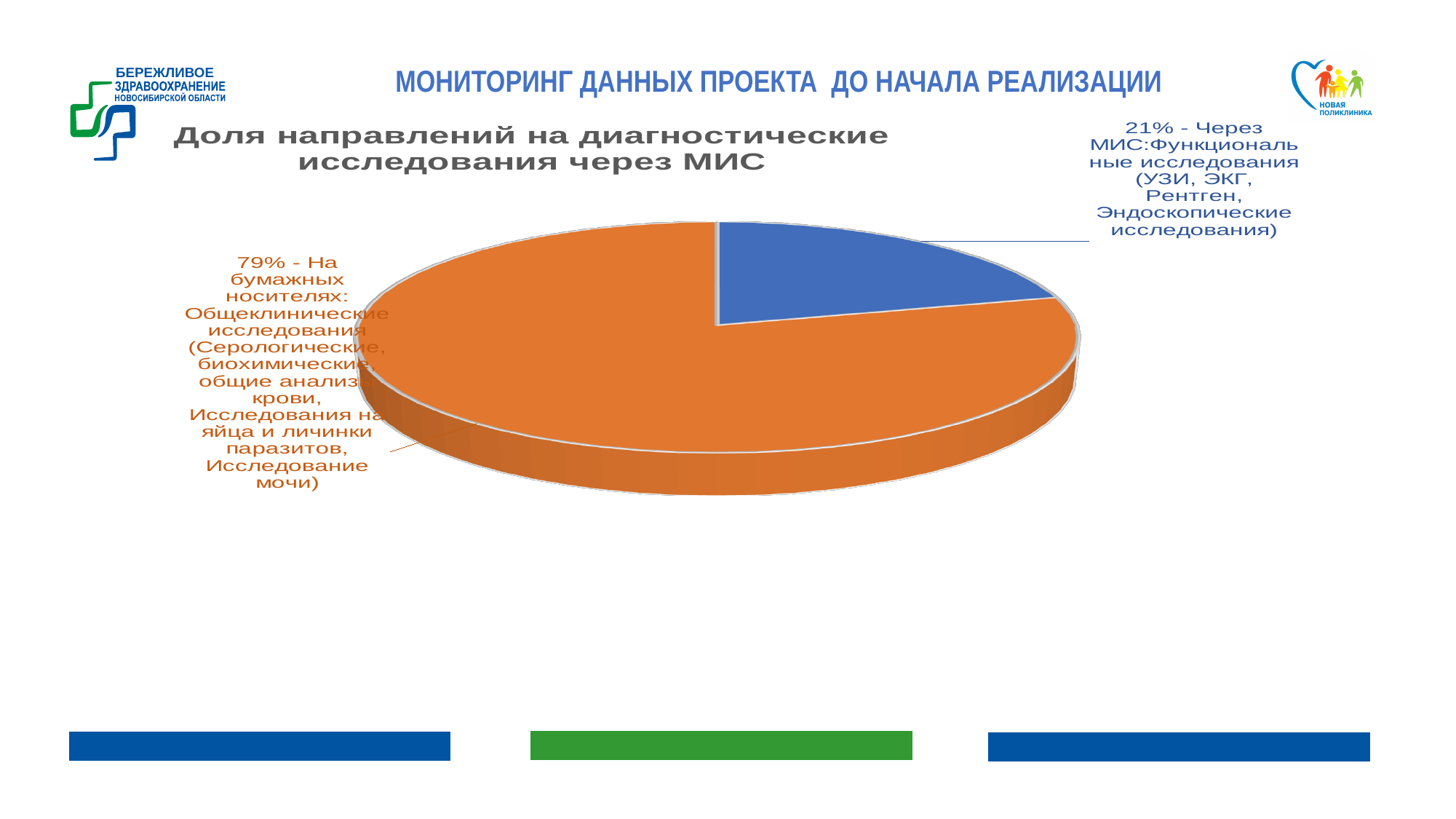
Which slice is the largest? На бумажных носителях (79%) What colour is the slice for referrals through МИС? Blue What share of referrals is on paper (На бумажных носителях)? 79% What share of referrals goes through МИС (Через МИС)? 21% What is the difference in percentage points between the paper share and the МИС share? 58 Which slice is the smallest? Через МИС (21%) How many slices does the pie chart have? 2 What kind of chart is shown on the slide? Pie chart Which is larger: the share on paper or the share through МИС? On paper (79%) Is the share of referrals through МИС greater or less than 50%? less What is the title of the chart? Доля направлений на диагностические исследования через МИС